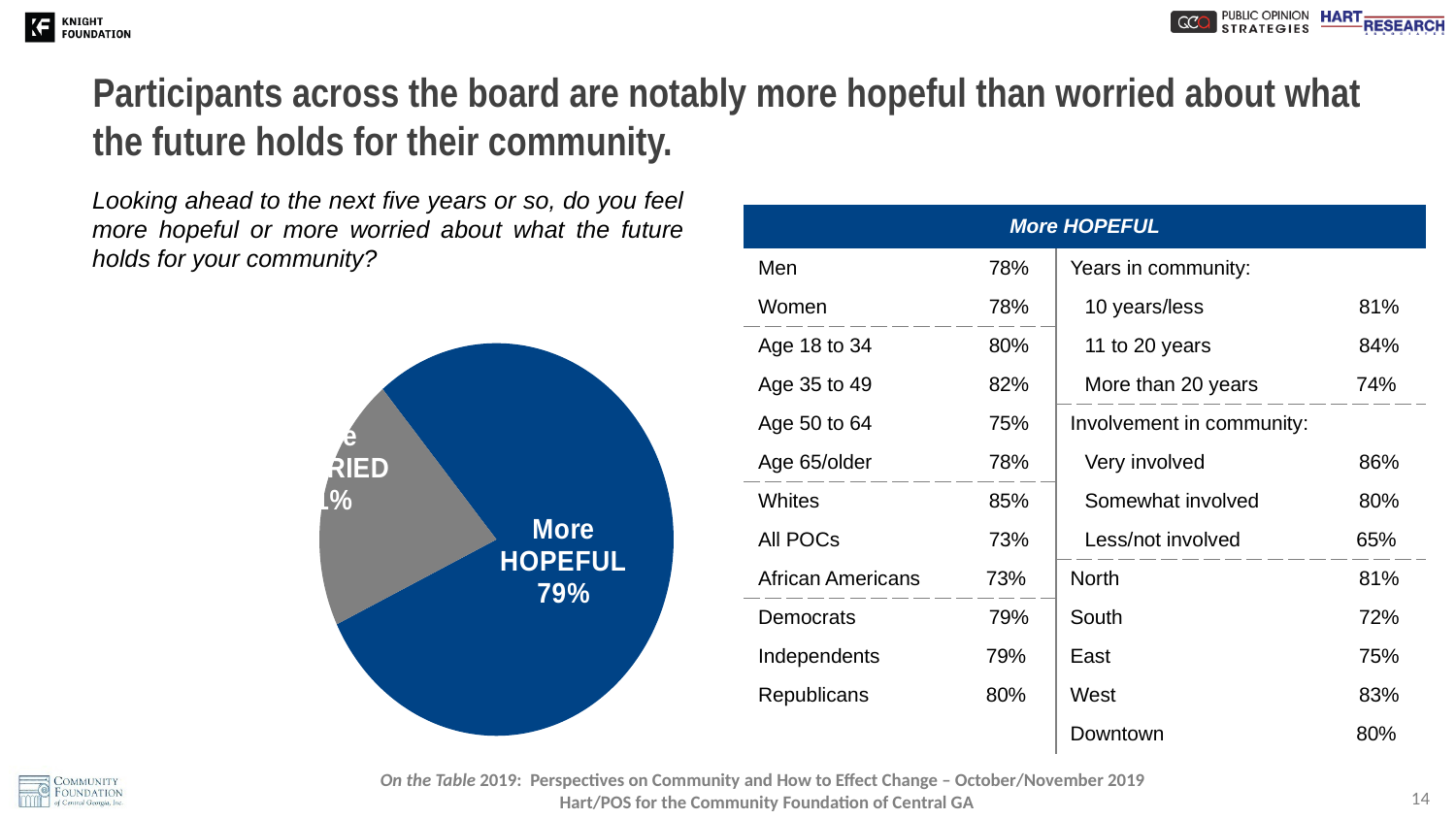
In the More HOPEFUL table, what is the value for Less/not involved? 65% In the pie chart, what percentage of participants are More HOPEFUL? 79% What kind of chart is shown on the left of the slide? pie chart What colour is the More HOPEFUL slice in the pie chart? blue What is the heading of the table on the right of the slide? More HOPEFUL Which slice of the pie chart is the largest? More HOPEFUL In the More HOPEFUL table, what is the difference between Very involved and Less/not involved? 21% In the More HOPEFUL table, which group has the highest value? Very involved How many slices does the pie chart have? 2 In the More HOPEFUL table, what is the value for Whites? 85% In the pie chart, which is larger: the More HOPEFUL slice or the More WORRIED slice? More HOPEFUL What share of the pie does the More HOPEFUL slice represent? 79%